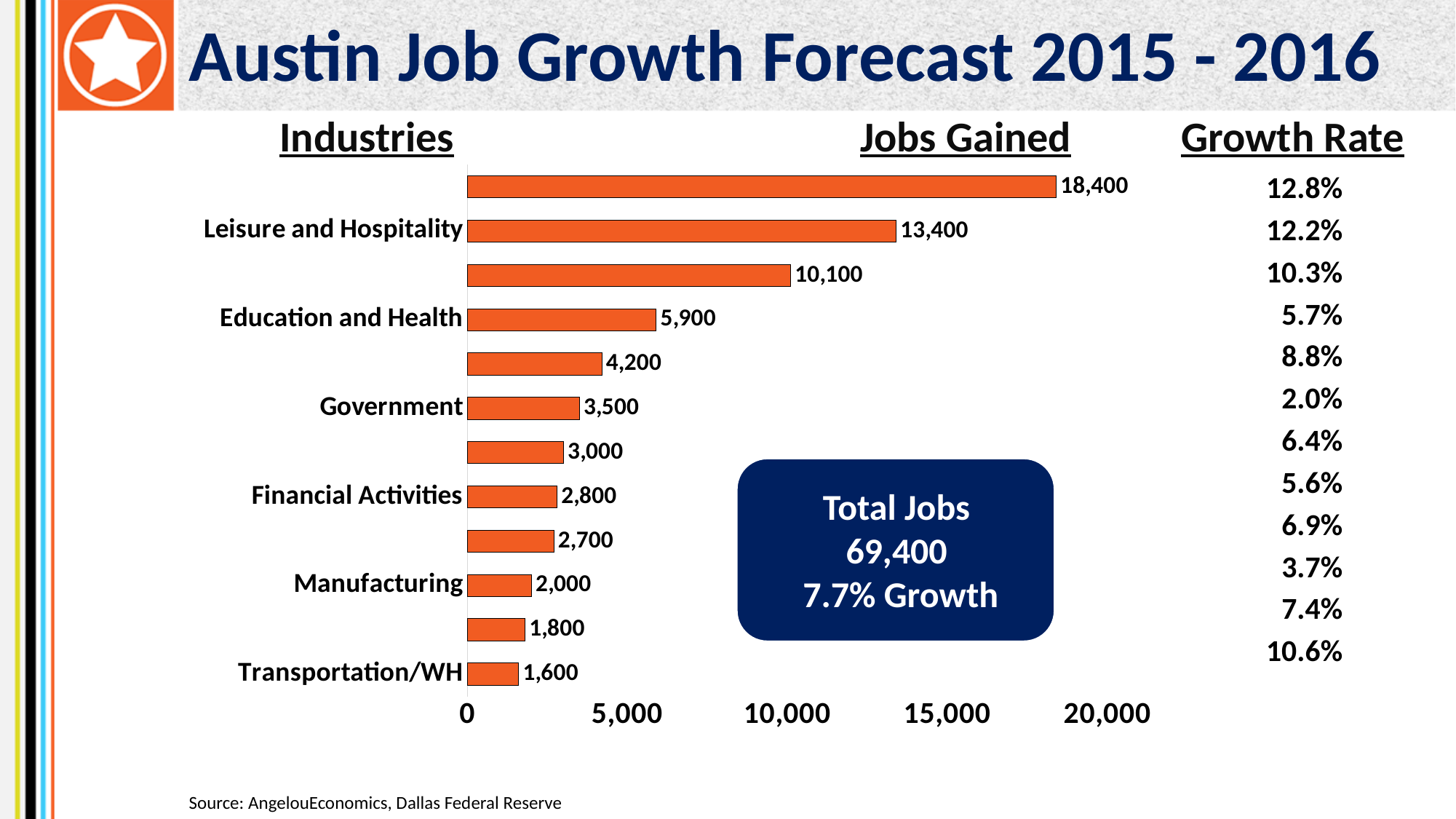
Which has more jobs gained, Government or Manufacturing? Government What total number of jobs is stated in the callout box on the slide? 69,400 What is the jobs gained value for Financial Activities? 2,800 What is the jobs gained value for Manufacturing? 2,000 What type of chart is shown on the slide? bar chart How many bars are plotted on the chart? 12 Which labeled industry has the lowest number of jobs gained? Transportation/WH What is the difference in jobs gained between Leisure and Hospitality and Education and Health? 7,500 What is the largest jobs gained value shown on the chart? 18,400 What is the jobs gained value for Government? 3,500 How many jobs are forecast to be gained in Education and Health? 5,900 How many jobs are forecast to be gained in Leisure and Hospitality? 13,400